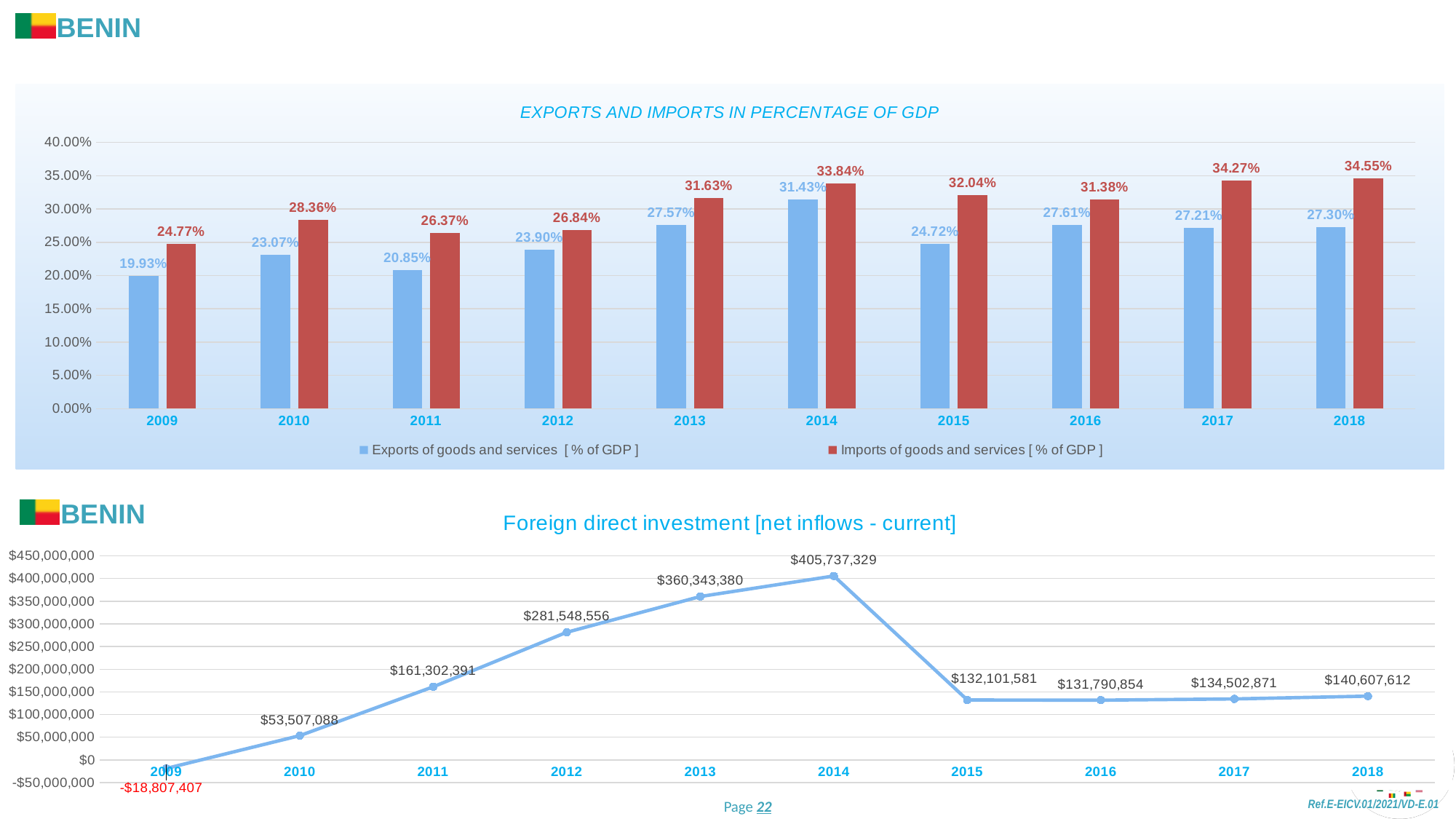
In the 'Foreign direct investment [net inflows - current]' chart, what is the value for 2012? $281,548,556 In the 'Foreign direct investment [net inflows - current]' chart, which year has the lowest value? 2009 In the 'EXPORTS AND IMPORTS IN PERCENTAGE OF GDP' chart, what is the value of Exports of goods and services in 2014? 31.43% In the 'EXPORTS AND IMPORTS IN PERCENTAGE OF GDP' chart, what is the difference between Imports and Exports in 2018? 7.25% What kind of chart is the 'EXPORTS AND IMPORTS IN PERCENTAGE OF GDP' chart? Bar chart In the 'Foreign direct investment [net inflows - current]' chart, which year has the highest value? 2014 In the 'EXPORTS AND IMPORTS IN PERCENTAGE OF GDP' chart, what is the value of Imports of goods and services in 2011? 26.37% In the 'Foreign direct investment [net inflows - current]' chart, what is the difference between the 2014 and 2013 values? $45,393,949 In the 'EXPORTS AND IMPORTS IN PERCENTAGE OF GDP' chart, how many series does the legend list? 2 In the 'EXPORTS AND IMPORTS IN PERCENTAGE OF GDP' chart, which year has the highest Imports of goods and services value? 2018 In the 'EXPORTS AND IMPORTS IN PERCENTAGE OF GDP' chart, which year has the lowest Exports of goods and services value? 2009 In the 'Foreign direct investment [net inflows - current]' chart, how many years are plotted? 10